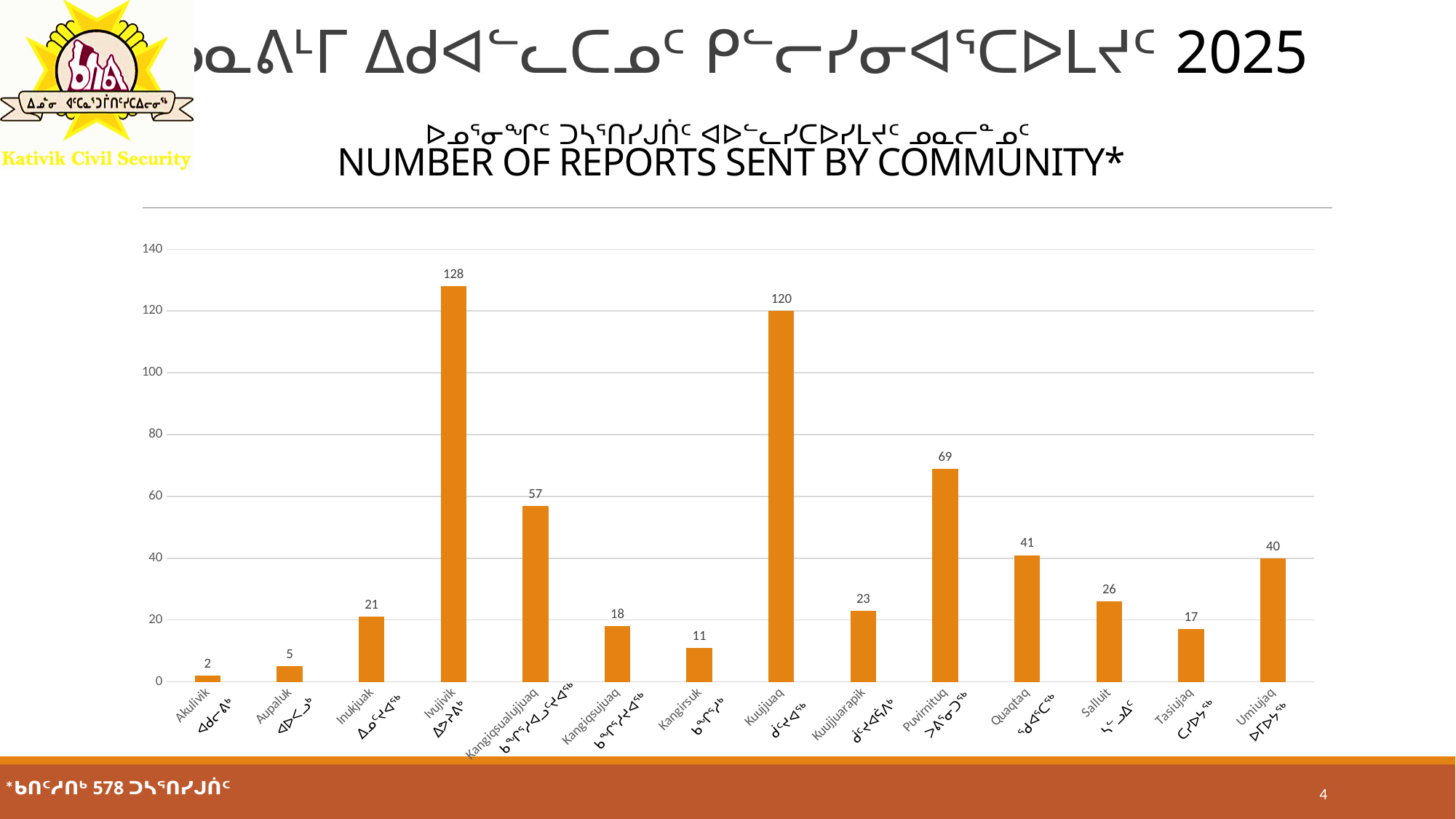
Is the value for Kuujjuaq greater or less than 100? greater Which community has the lowest number of reports sent? Akulivik What is the number of reports sent for Puvirnituq? 69 What kind of chart is shown on the slide? Bar chart Which has more reports sent, Umiujaq or Kuujjuarapik? Umiujaq What is the English title of the chart? NUMBER OF REPORTS SENT BY COMMUNITY* What is the difference between the number of reports for Kangiqsualujjuaq and Quaqtaq? 16 What is the number of reports sent for Ivujivik? 128 How many communities are shown on the chart? 14 What is the difference between the number of reports for Ivujivik and Kuujjuaq? 8 Which community has the highest number of reports sent? Ivujivik What is the number of reports sent for Salluit? 26